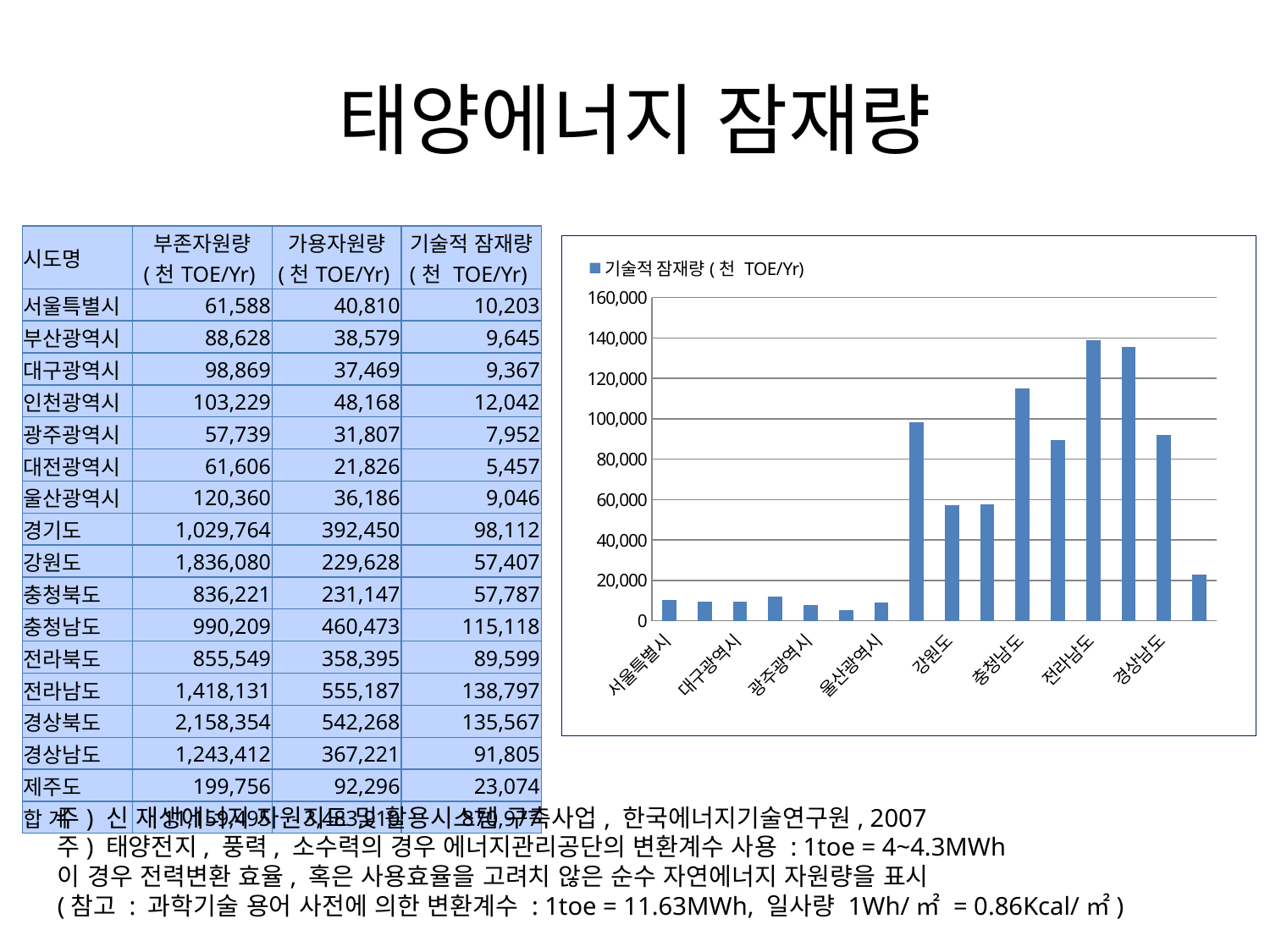
What is the highest value shown on the chart's vertical axis? 160,000 What is the 기술적 잠재량 value for 전라남도 shown on the slide? 138,797 How many series does the chart legend list? 1 Is the value for 충청남도 in the chart greater or less than 100,000? greater What is the legend entry of the chart? 기술적 잠재량 (천 TOE/Yr) Which region has the lowest bar in the chart? 대전광역시 In the chart, which is larger, the value for 충청남도 or the value for 전라북도? 충청남도 Which region has the highest bar in the chart? 전라남도 Is the value for 경상남도 in the chart greater or less than 80,000? greater Is the value for 서울특별시 in the chart greater or less than 20,000? less What kind of chart is shown on the slide? bar chart How many bars are plotted in the chart? 16